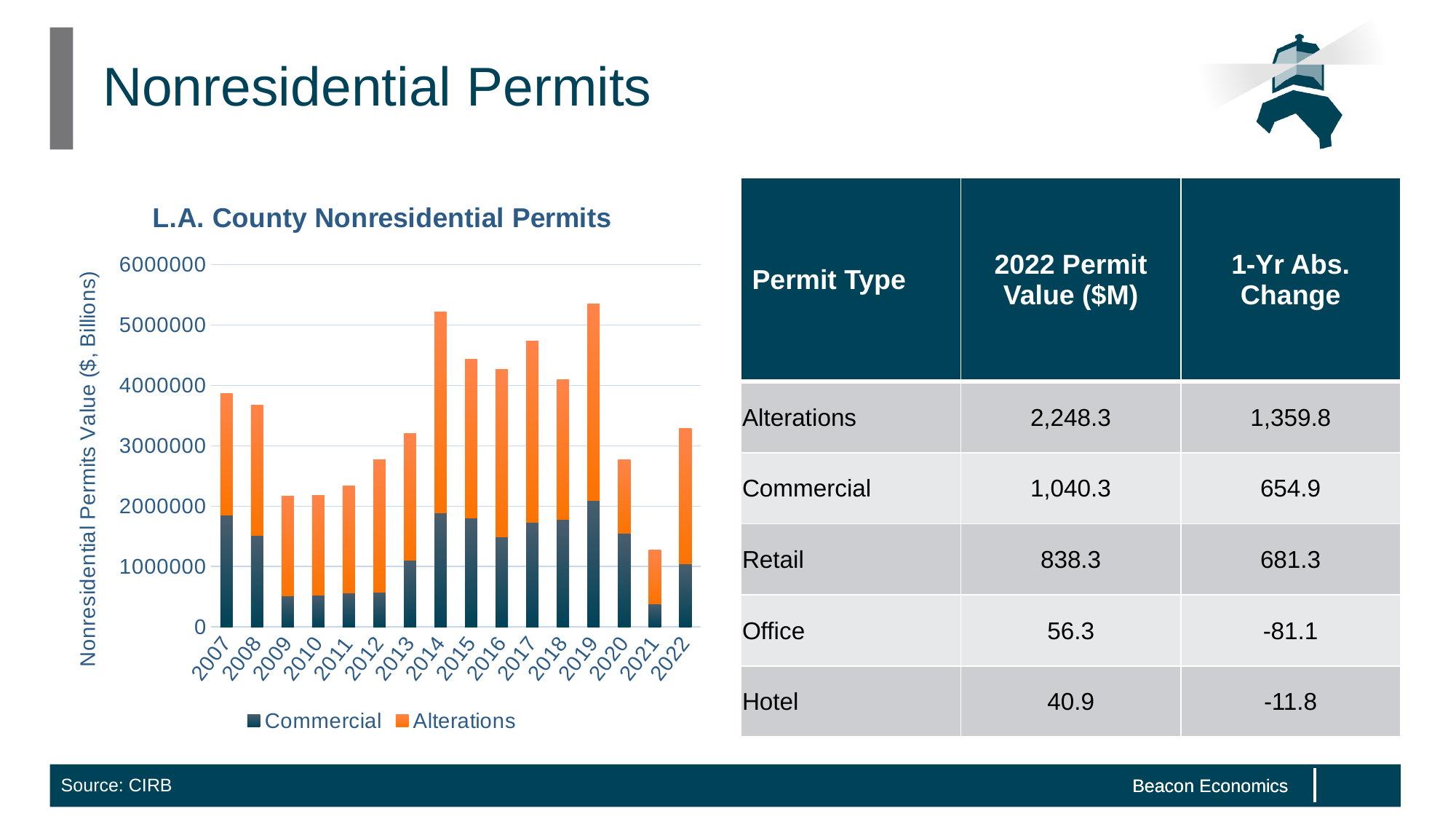
Is the total bar for 2019 greater or less than 5000000? greater How many years are shown on the x axis of the L.A. County Nonresidential Permits chart? 16 Which series is shown in orange in the chart? Alterations Which year has the lowest total nonresidential permits value in the chart? 2021 What kind of chart is shown on the slide? Stacked bar chart Which year has the larger total bar, 2020 or 2021? 2020 Which year has the larger Commercial value, 2007 or 2008? 2007 Is the total bar for 2022 greater or less than 3000000? greater Is the total bar for 2021 greater or less than 2000000? less How many series does the legend of the chart list? 2 Do the total bars rise or fall from 2009 to 2014? rise